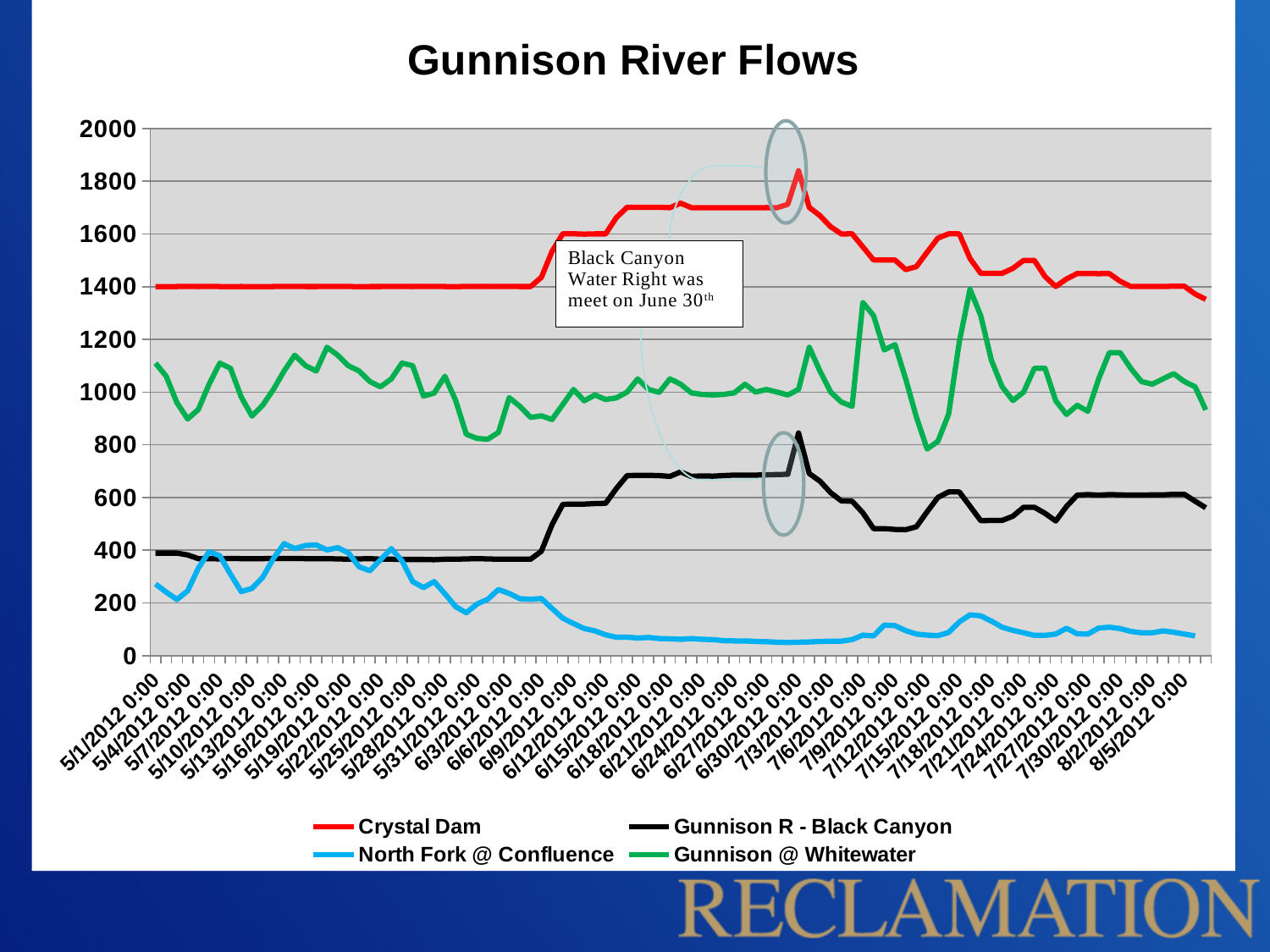
Is the value for Gunnison R - Black Canyon on 5/1/2012 greater or less than 600? less Is the value for North Fork @ Confluence on 7/3/2012 greater or less than 200? less Is the value for Crystal Dam on 6/18/2012 greater or less than 1600? greater What kind of chart is shown on the slide? line chart On 5/1/2012, which is larger: Gunnison @ Whitewater or Gunnison R - Black Canyon? Gunnison @ Whitewater Which colour is used for the Crystal Dam series? red Does the North Fork @ Confluence series rise or fall overall from 5/1/2012 to 8/5/2012? fall On 6/30/2012, which is larger: Crystal Dam or North Fork @ Confluence? Crystal Dam How many series does the legend list? 4 What is the title of the chart? Gunnison River Flows Which series has the highest values across the whole chart? Crystal Dam